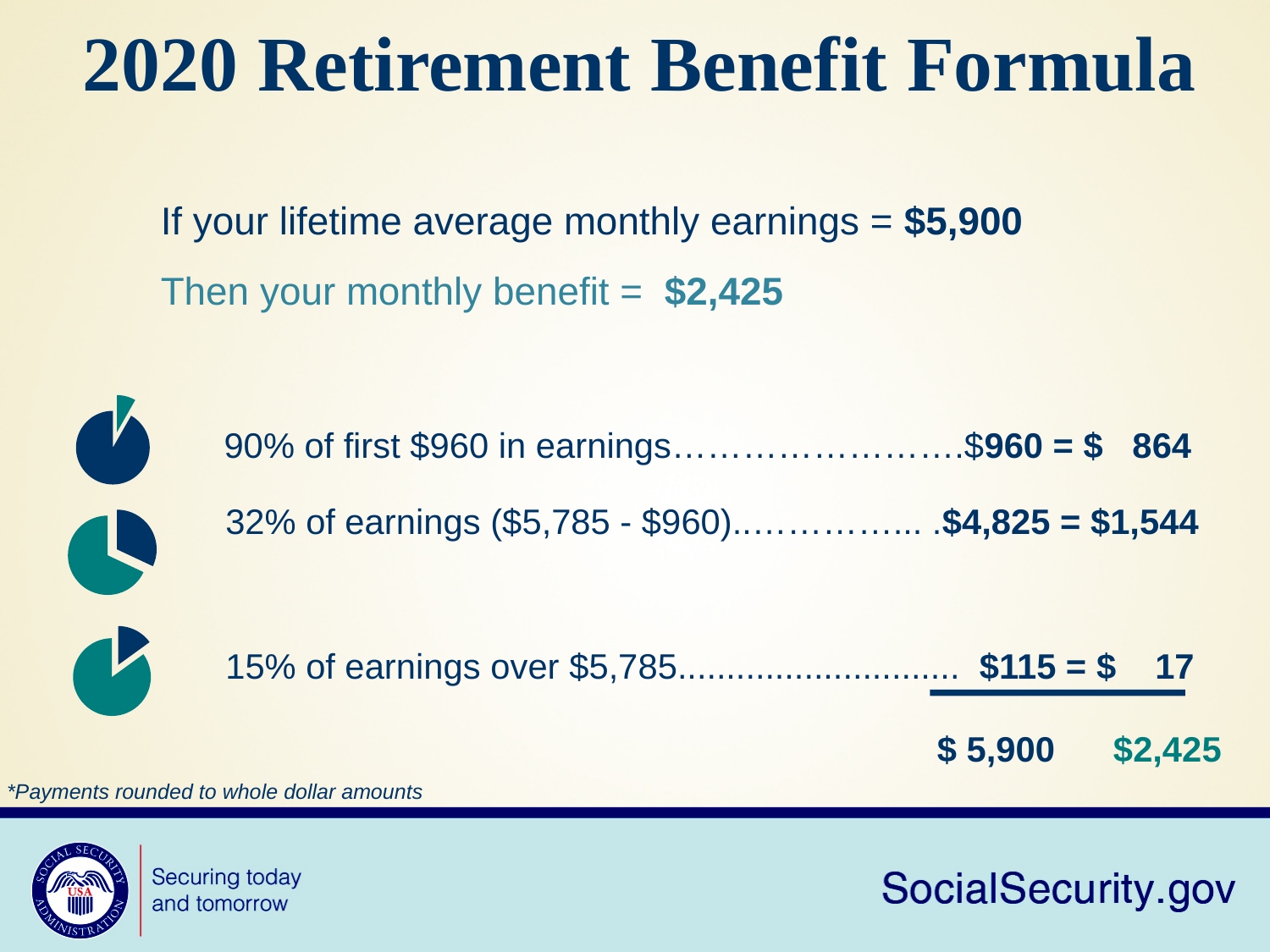
What kind of charts are the three small graphics on the left side of the slide? pie charts Which of the three pie charts shows the largest filled share? the top pie chart (90%) Which of the three pie charts shows the smallest filled share? the bottom pie chart (15%) What is the title of the slide containing the three pie charts? 2020 Retirement Benefit Formula What colour is the filled portion of the top pie chart? dark navy blue Is the share shown in the middle pie chart (32%) larger or smaller than the share shown in the bottom pie chart (15%)? larger What percentage does the middle pie chart, next to '32% of earnings ($5,785 - $960)', represent? 32% What percentage does the top pie chart, next to '90% of first $960 in earnings', represent? 90% What is the difference between the percentage shown by the top pie chart and the percentage shown by the bottom pie chart? 75% How many pie charts are shown on the slide? 3 What percentage does the bottom pie chart, next to '15% of earnings over $5,785', represent? 15%